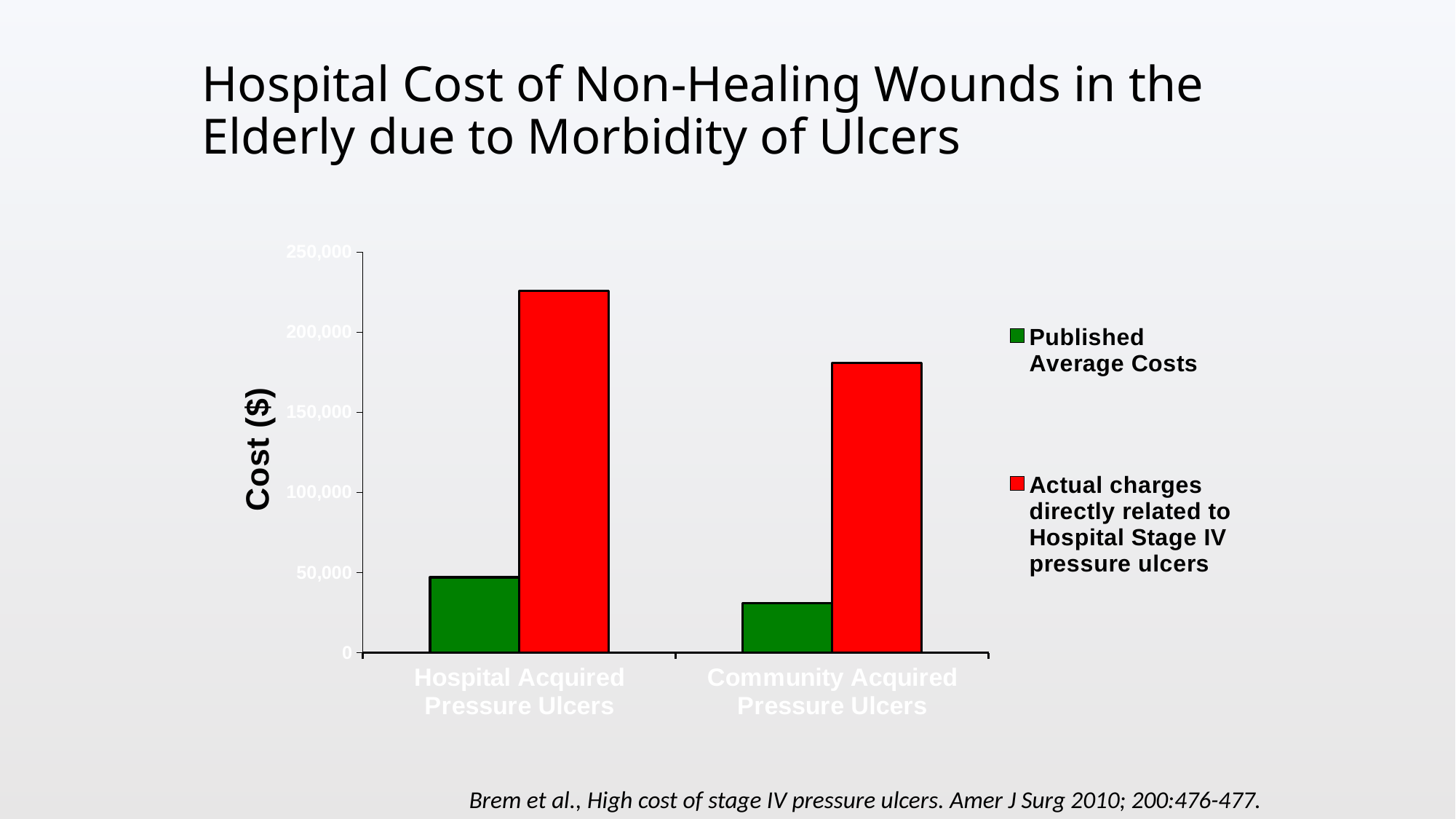
Which category has the lowest Published Average Costs? Community Acquired Pressure Ulcers How many categories are shown on the x axis? 2 How many series does the legend list? 2 Is the value for Actual charges directly related to Hospital Stage IV pressure ulcers for Community Acquired Pressure Ulcers greater or less than 200,000? less What kind of chart is shown on the slide? bar chart What colour are the bars for Published Average Costs? green For Hospital Acquired Pressure Ulcers, which is larger: Published Average Costs or Actual charges directly related to Hospital Stage IV pressure ulcers? Actual charges directly related to Hospital Stage IV pressure ulcers What is the label of the y axis? Cost ($) Which category has the highest Actual charges directly related to Hospital Stage IV pressure ulcers? Hospital Acquired Pressure Ulcers Is the value for Actual charges directly related to Hospital Stage IV pressure ulcers for Hospital Acquired Pressure Ulcers greater or less than 200,000? greater Is the value for Published Average Costs for Community Acquired Pressure Ulcers greater or less than 50,000? less